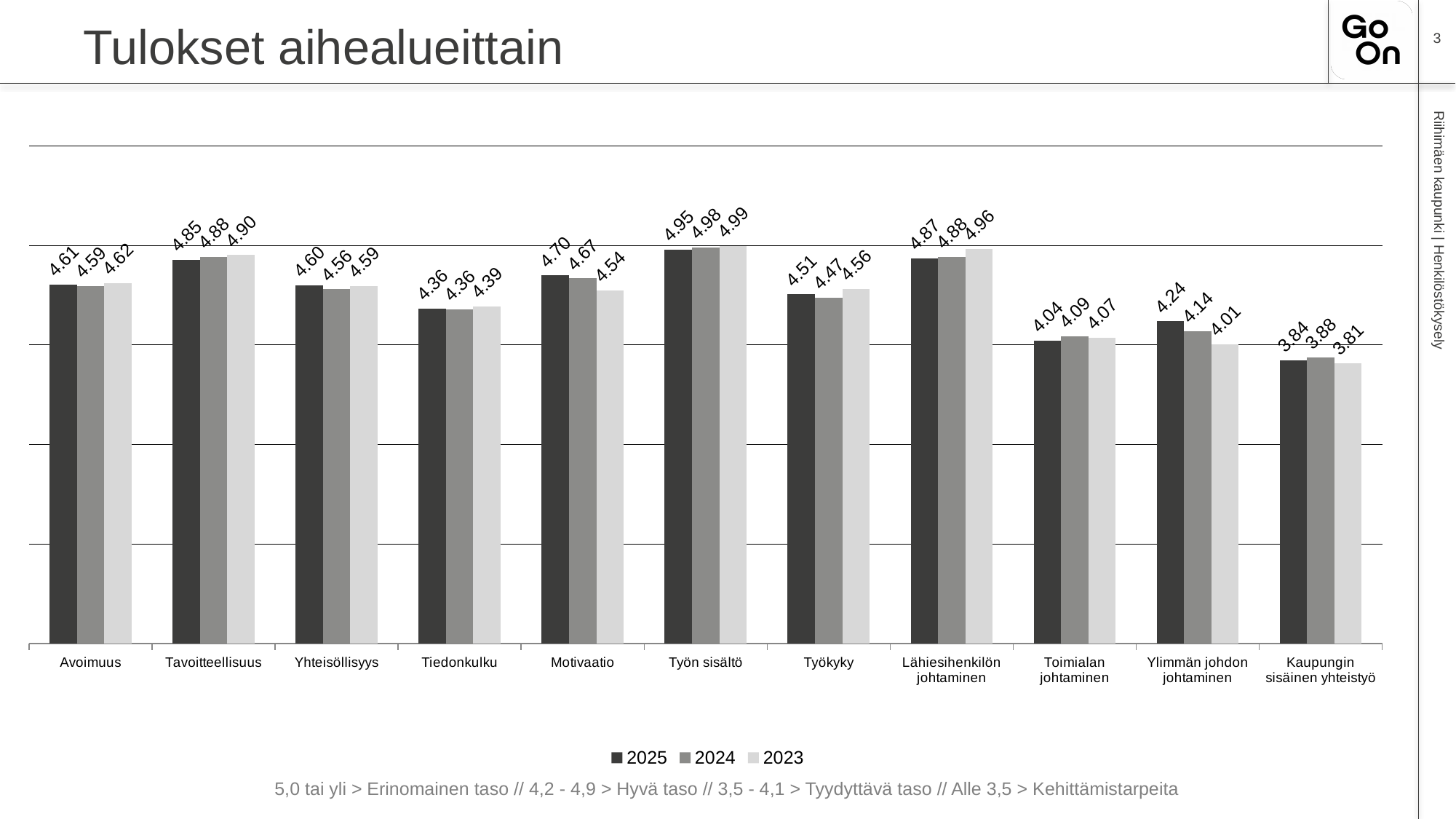
How many series does the legend list? 3 Which series is shown with the darkest bars according to the legend? 2025 Which category has the lowest value in the 2023 series? Kaupungin sisäinen yhteistyö What is the value for Toimialan johtaminen in the 2024 series? 4.09 What is the value for Avoimuus in the 2025 series? 4.61 What kind of chart is shown on the slide? Bar chart Which category has the highest value in the 2025 series? Työn sisältö What is the title of the slide? Tulokset aihealueittain What is the difference between the 2025 and 2023 values for Ylimmän johdon johtaminen? 0.23 What is the value for Tiedonkulku in the 2023 series? 4.39 How many categories are shown on the x axis? 11 For Motivaatio, which is larger: the 2025 value or the 2023 value? 2025